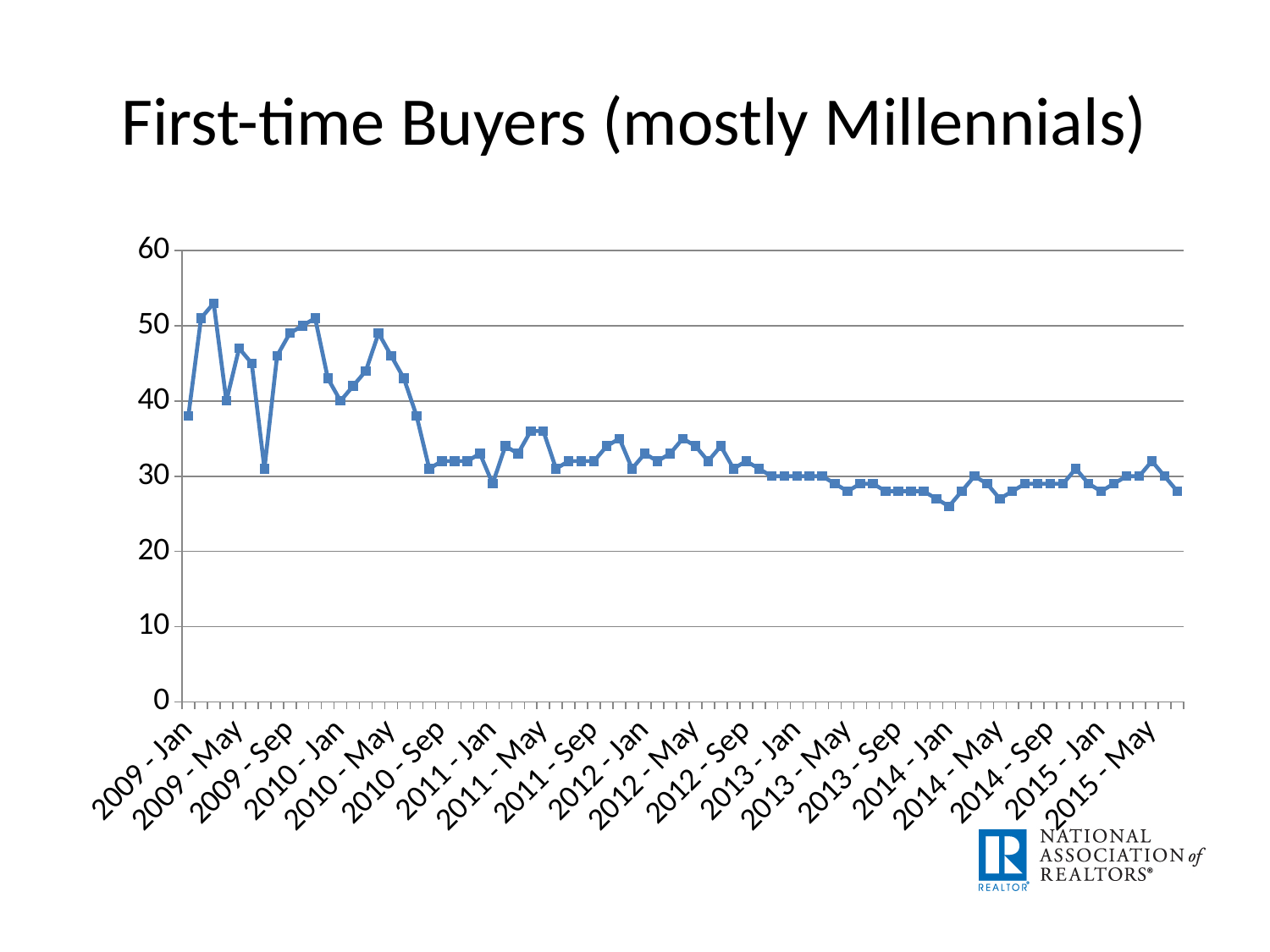
Is the value for 2011 - May greater or less than 30? greater What is the highest value shown on the vertical axis? 60 Is the value for 2009 - Sep greater or less than 40? greater Which is larger, the value for 2009 - May or the value for 2014 - Jan? 2009 - May Is the value for 2014 - Jan greater or less than 30? less What kind of chart is shown on the slide? line chart What is the title of the chart? First-time Buyers (mostly Millennials) Overall, do the values rise or fall from 2009 - Jan to 2015 - May? fall How many data series are plotted on the chart? 1